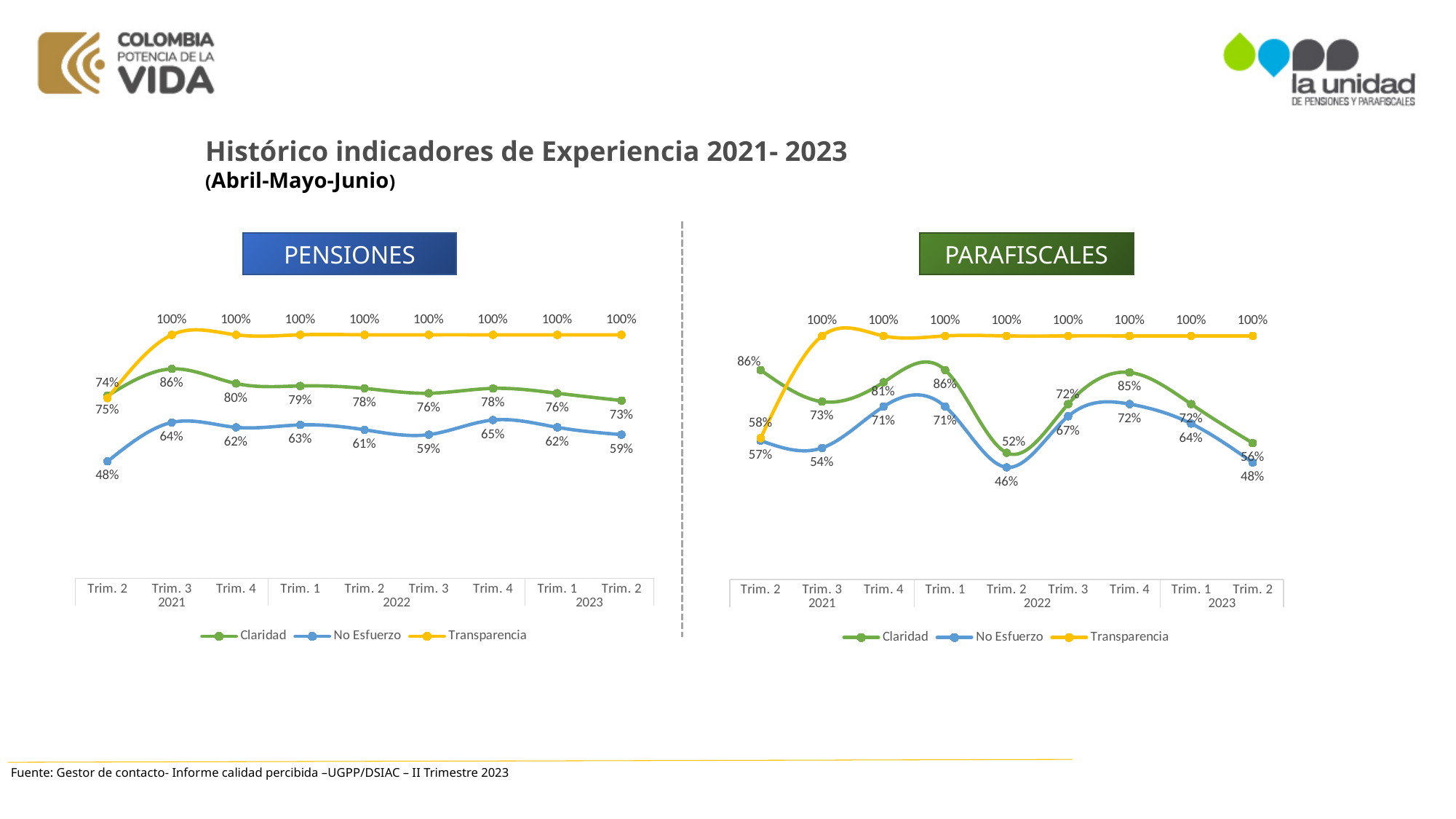
In the PARAFISCALES chart, what is the Claridad value for Trim. 2 2023? 56% How many series does the legend of the PARAFISCALES chart list? 3 In the PENSIONES chart, what is the Transparencia value for Trim. 2 2021? 74% In the PENSIONES chart, what is the difference between the Claridad and No Esfuerzo values for Trim. 2 2023? 14% In the PARAFISCALES chart, what is the No Esfuerzo value for Trim. 2 2022? 46% What type of chart is the PARAFISCALES chart? Line chart How many quarters are plotted on the x axis of the PENSIONES chart? 9 In the PENSIONES chart, which quarter has the highest No Esfuerzo value? Trim. 4 2022 In the PENSIONES chart, what is the Claridad value for Trim. 3 2021? 86% In the PENSIONES chart, what is the No Esfuerzo value for Trim. 2 2021? 48% In the PARAFISCALES chart, which quarter has the lowest Claridad value? Trim. 2 2022 In the PARAFISCALES chart, which is larger for Trim. 4 2022: Claridad or No Esfuerzo? Claridad